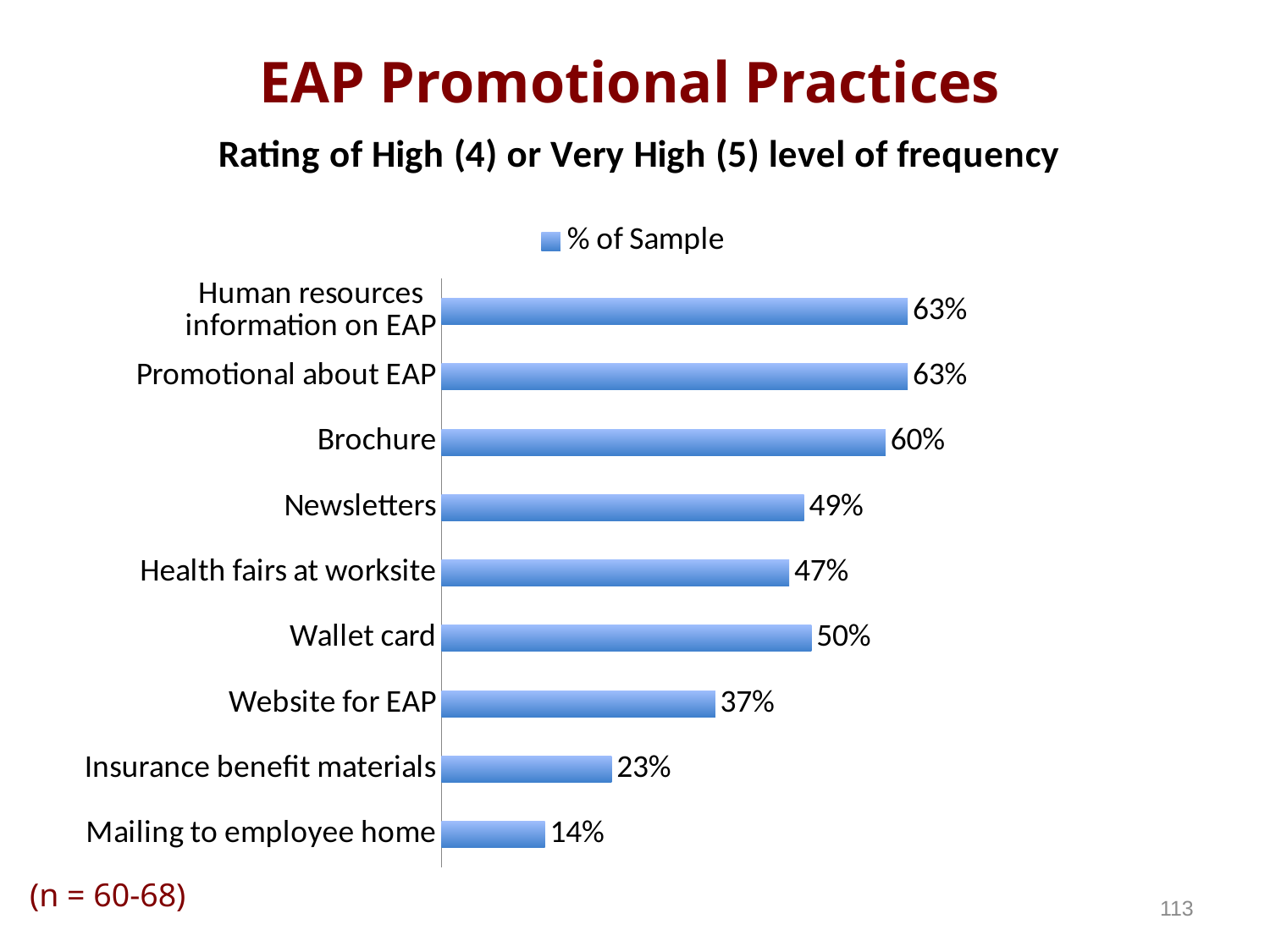
What is the value for Brochure? 60% What series name does the legend show? % of Sample What is the value for Wallet card? 50% Which is larger, the value for Newsletters or the value for Website for EAP? Newsletters What kind of chart is shown on the slide? Bar chart Which category has the lowest value? Mailing to employee home What is the value for Mailing to employee home? 14% What is the difference between the values for Brochure and Website for EAP? 23% What is the difference between the values for Wallet card and Mailing to employee home? 36% Which is larger, the value for Insurance benefit materials or the value for Health fairs at worksite? Health fairs at worksite How many categories are shown in the chart? 9 What is the value for Insurance benefit materials? 23%